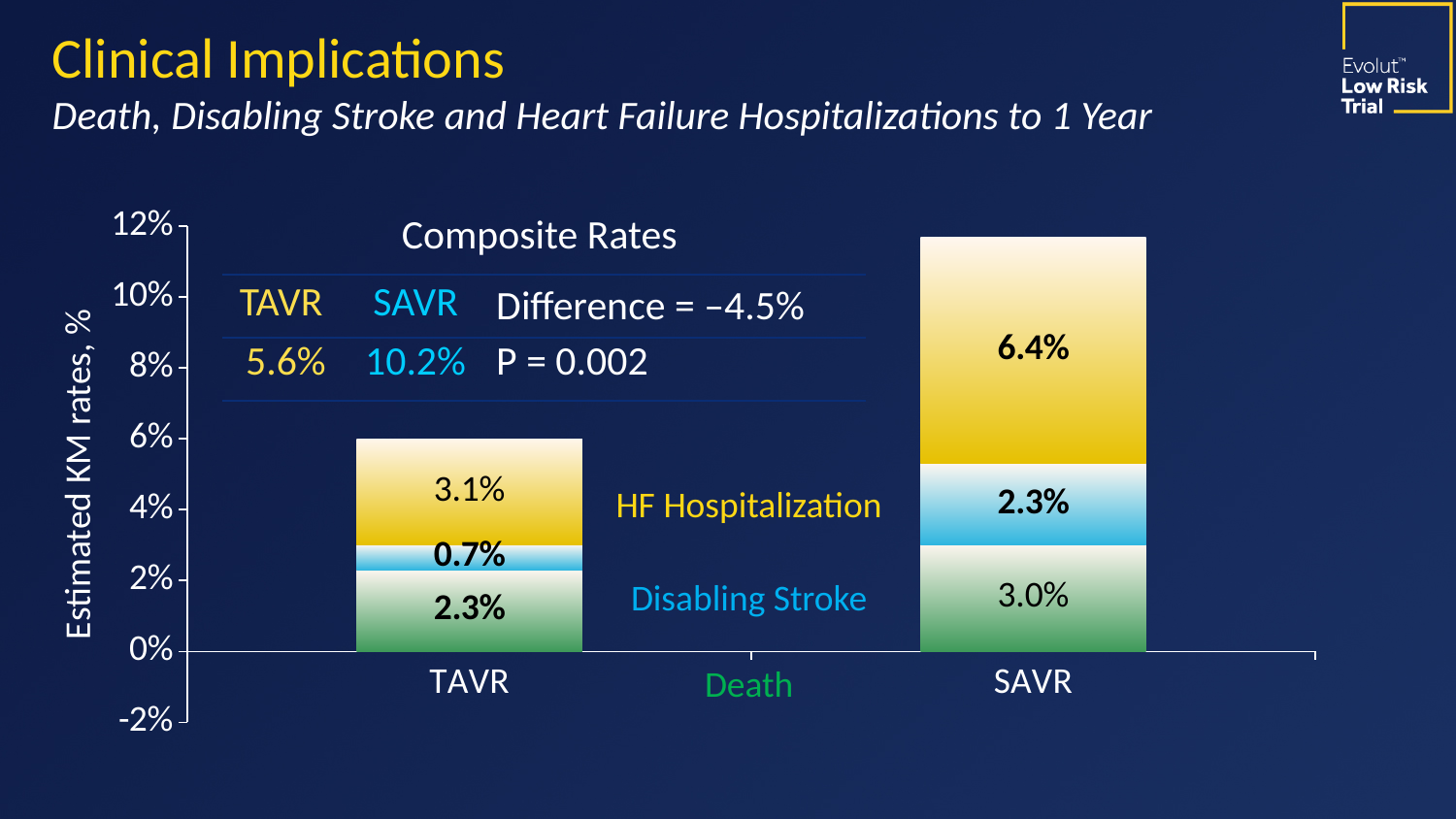
What type of chart is shown on the slide? Stacked bar chart How many bars are shown in the chart? 2 Which segment is the largest in the SAVR bar? HF Hospitalization Which group has the higher HF Hospitalization rate, TAVR or SAVR? SAVR What is the difference between the Death rates for SAVR and TAVR? 0.7% What is the Disabling Stroke rate for SAVR? 2.3% What is the Disabling Stroke rate for TAVR? 0.7% What is the HF Hospitalization rate for TAVR? 3.1% What is the difference between the HF Hospitalization rates for SAVR and TAVR? 3.3% How many series (outcome types) are stacked in each bar? 3 What is the HF Hospitalization rate for SAVR? 6.4% What is the Death rate for TAVR? 2.3%